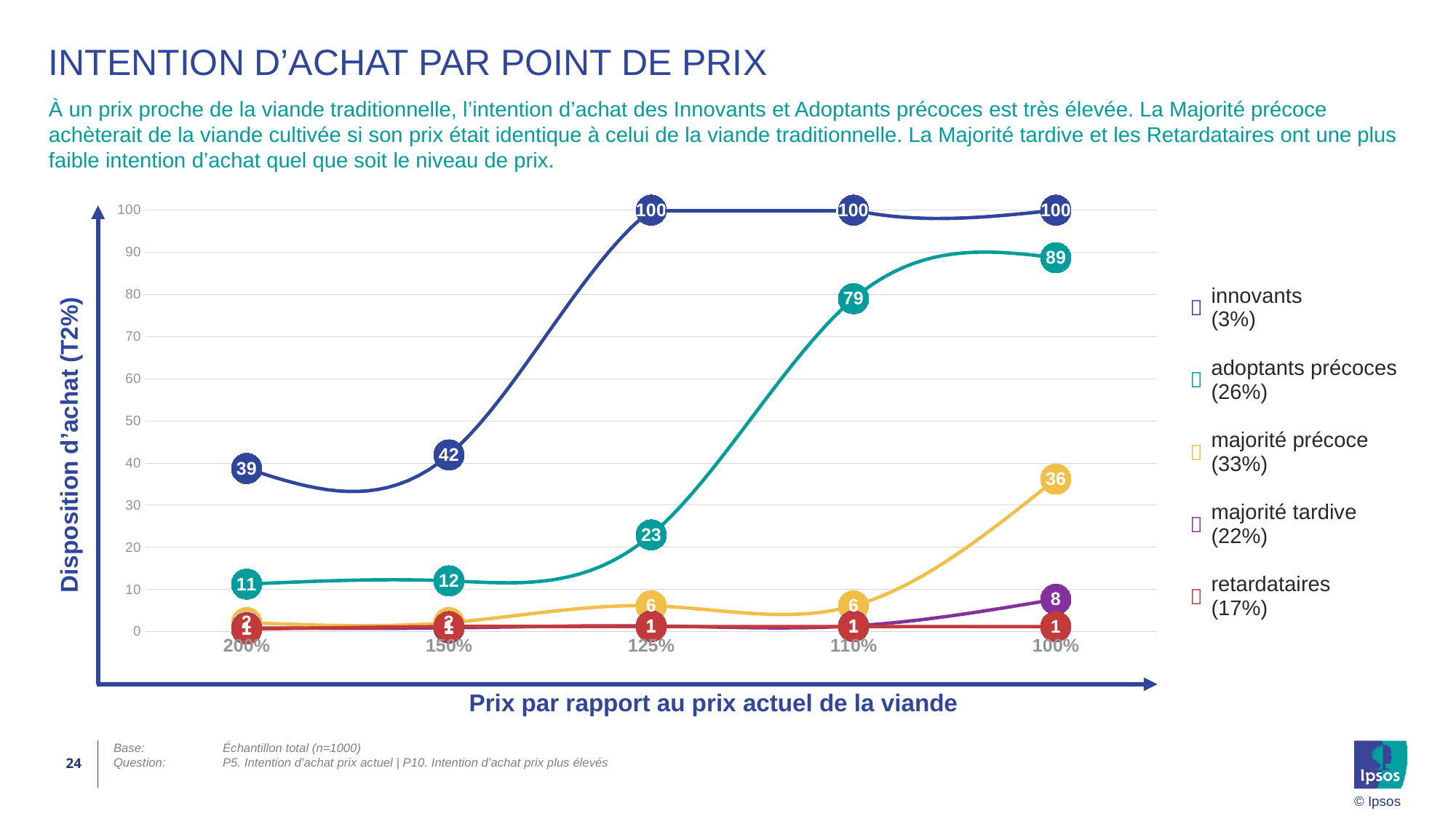
What is the difference between adoptants précoces at 100% and at 110%? 10 How many price points are shown on the x axis? 5 Which series has the highest value at 100%? innovants Which series has the lowest value at 100%? retardataires How many series does the legend list? 5 Does the adoptants précoces line rise or fall from 200% to 100%? rise What is the value for majorité précoce at 100%? 36 What is the value for innovants at 200%? 39 What is the value for adoptants précoces at 110%? 79 Which is larger at 125%: innovants or adoptants précoces? innovants What is the value for majorité tardive at 100%? 8 What type of chart is shown on the slide? line chart